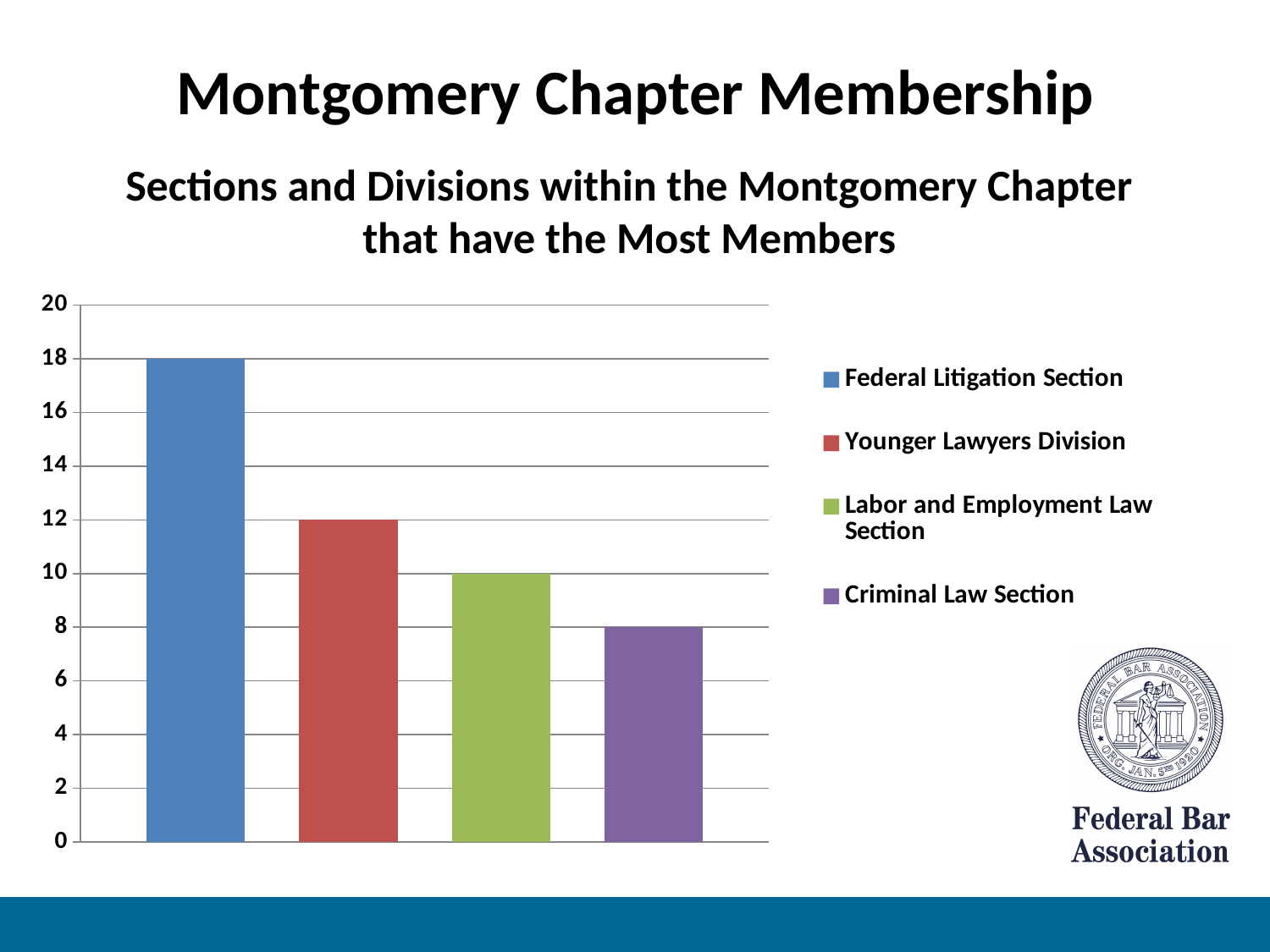
What kind of chart is shown on the slide? bar chart What is the value for the Criminal Law Section? 8 Which section or division has the highest value? Federal Litigation Section Is the value for the Younger Lawyers Division greater or less than 10? greater What colour is the bar for the Criminal Law Section? purple What is the value for the Federal Litigation Section? 18 What is the value for the Labor and Employment Law Section? 10 What is the difference between the Federal Litigation Section and the Younger Lawyers Division? 6 Which section or division has the lowest value? Criminal Law Section Which is larger, the Labor and Employment Law Section or the Criminal Law Section? Labor and Employment Law Section How many series does the legend list? 4 What is the value for the Younger Lawyers Division? 12